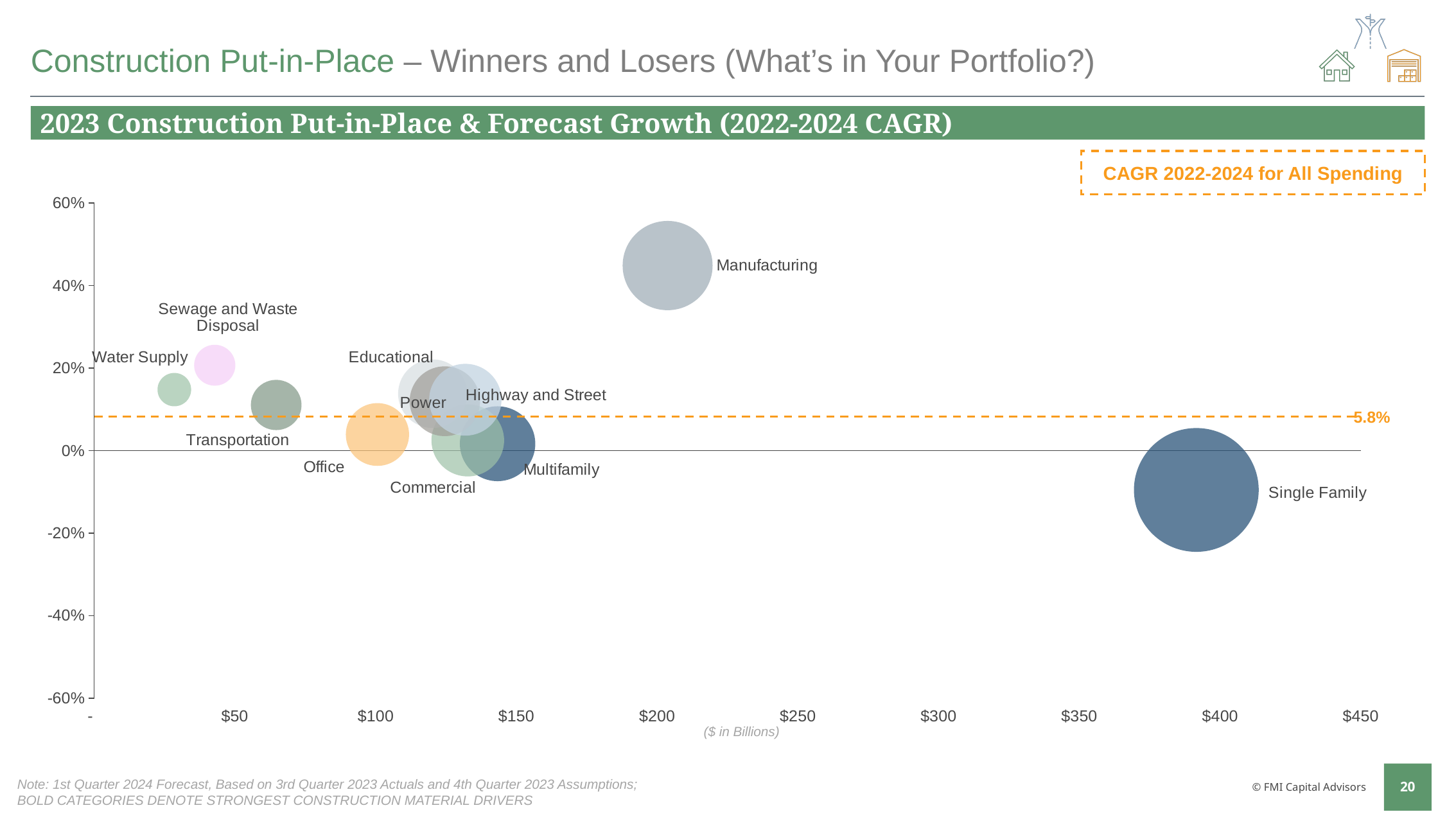
What kind of chart is shown on the slide? Bubble chart What is the CAGR 2022-2024 for All Spending shown by the dashed line? 5.8% Is the 2023 spending for Single Family greater or less than $350 billion? greater Which has the higher CAGR, Manufacturing or Single Family? Manufacturing Is the CAGR for Single Family greater or less than 0%? less Which category has the lowest forecast growth (CAGR)? Single Family Which category has the highest forecast growth (CAGR)? Manufacturing How many labelled categories (bubbles) are plotted on the chart? 11 Which has the larger 2023 spending, Single Family or Manufacturing? Single Family Is the CAGR for Manufacturing greater or less than 40%? greater What unit is given for the x axis of the chart? $ in Billions Which category has the largest 2023 construction put-in-place spending (furthest right on the x axis)? Single Family